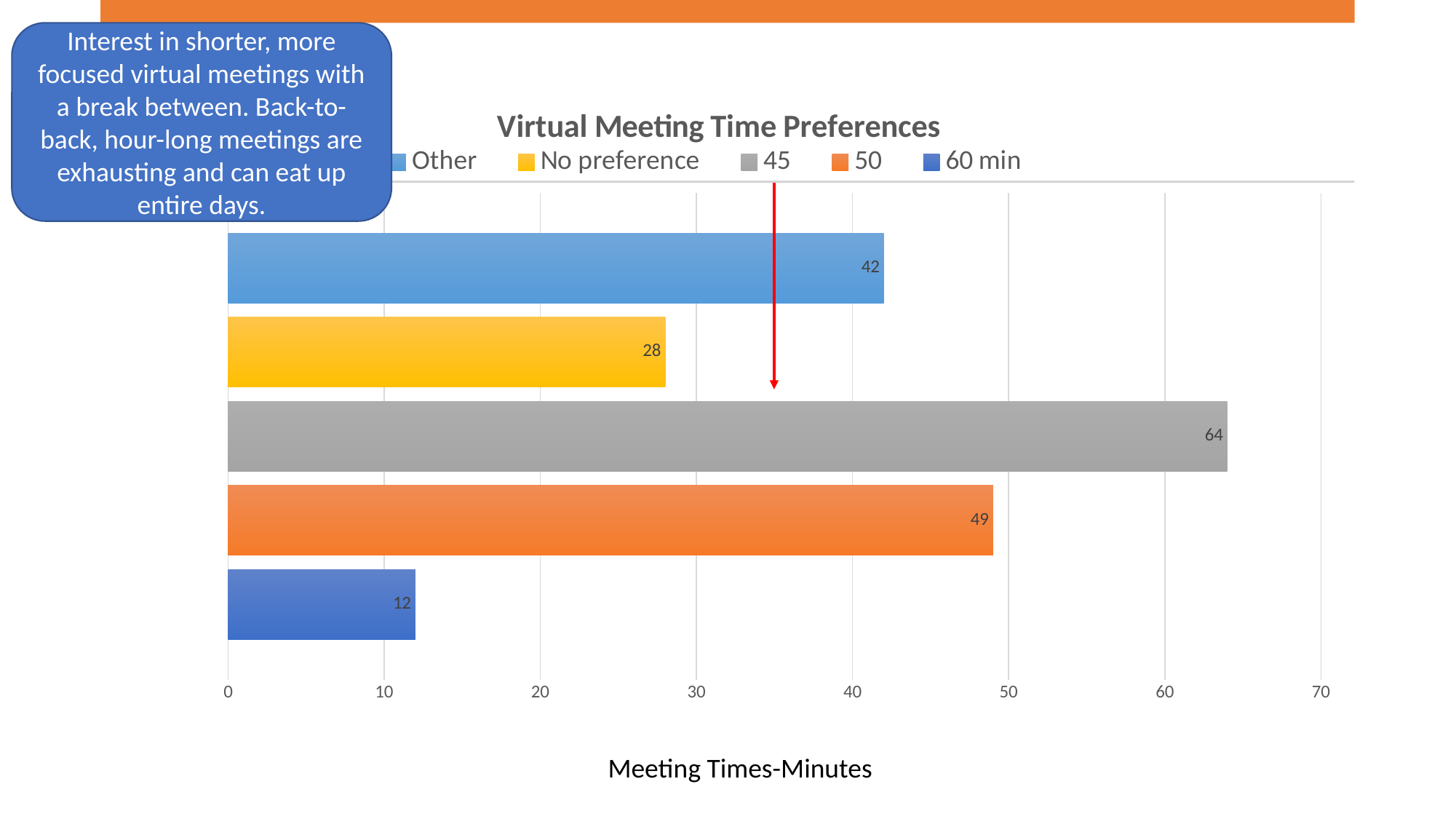
Which is larger, the value for "Other" or the value for "No preference"? Other Which option has the highest value? 45 How many bars are plotted in the chart? 5 How many entries does the legend list? 5 Which option has the lowest value? 60 min What is the value for "No preference"? 28 What is the value for the 45-minute option? 64 What is the value for the 60 min option? 12 Is the value for 50 greater or less than 40? greater What kind of chart is shown on the slide? Bar chart What is the value for "Other" in the Virtual Meeting Time Preferences chart? 42 What is the difference between the values for 45 and 50? 15